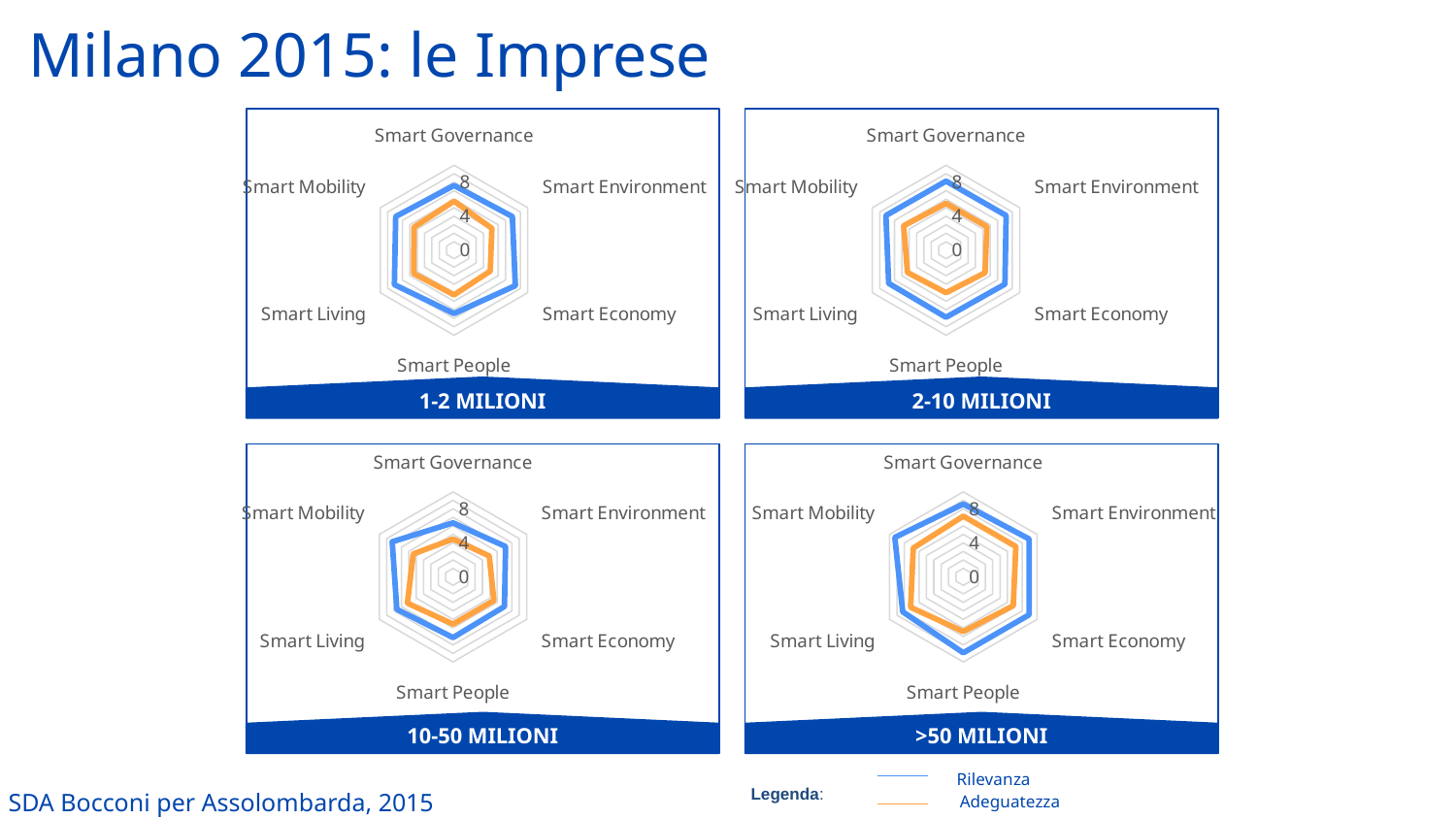
In the "1-2 MILIONI" chart, is the Rilevanza value for Smart Governance greater or less than 4? greater In the ">50 MILIONI" chart, is the Rilevanza value for Smart Governance greater or less than 4? greater What is the highest tick value shown on the axis of the "1-2 MILIONI" radar chart? 8 Which series is shown in orange according to the legend? Adeguatezza How many series does the legend list? 2 In the "10-50 MILIONI" chart, which series has the larger value for Smart Living, Rilevanza or Adeguatezza? Rilevanza How many categories (axes) does the "2-10 MILIONI" radar chart have? 6 Which series is shown in blue according to the legend? Rilevanza In the "2-10 MILIONI" chart, which series has the larger value for Smart People, Rilevanza or Adeguatezza? Rilevanza In the ">50 MILIONI" chart, is the Adeguatezza value for Smart Governance greater or less than 4? greater How many radar charts are shown on the slide? 4 What kind of chart is the "1-2 MILIONI" chart? radar chart